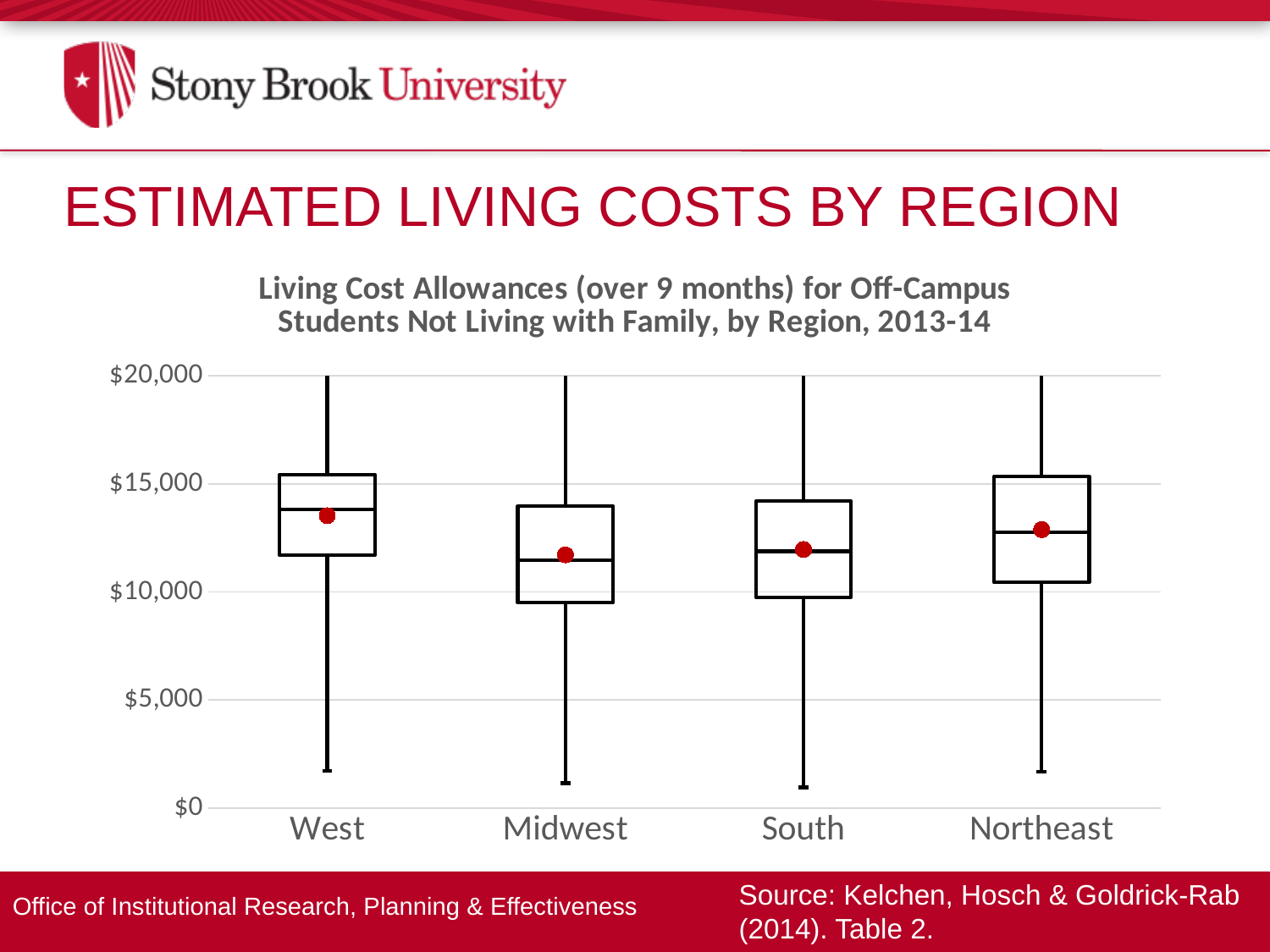
Is the top of the box for Northeast greater or less than $20,000? less Is the median line for West greater or less than $10,000? greater Which region has the highest red dot? West Is the bottom of the lower whisker for South greater or less than $5,000? less What is the title of the chart? Living Cost Allowances (over 9 months) for Off-Campus Students Not Living with Family, by Region, 2013-14 Which has a higher red dot, Northeast or South? Northeast Which has a higher median line, West or Midwest? West Which region has the highest median line? West How many regions are shown on the x axis of the chart? 4 What kind of chart is shown on the slide? Box plot